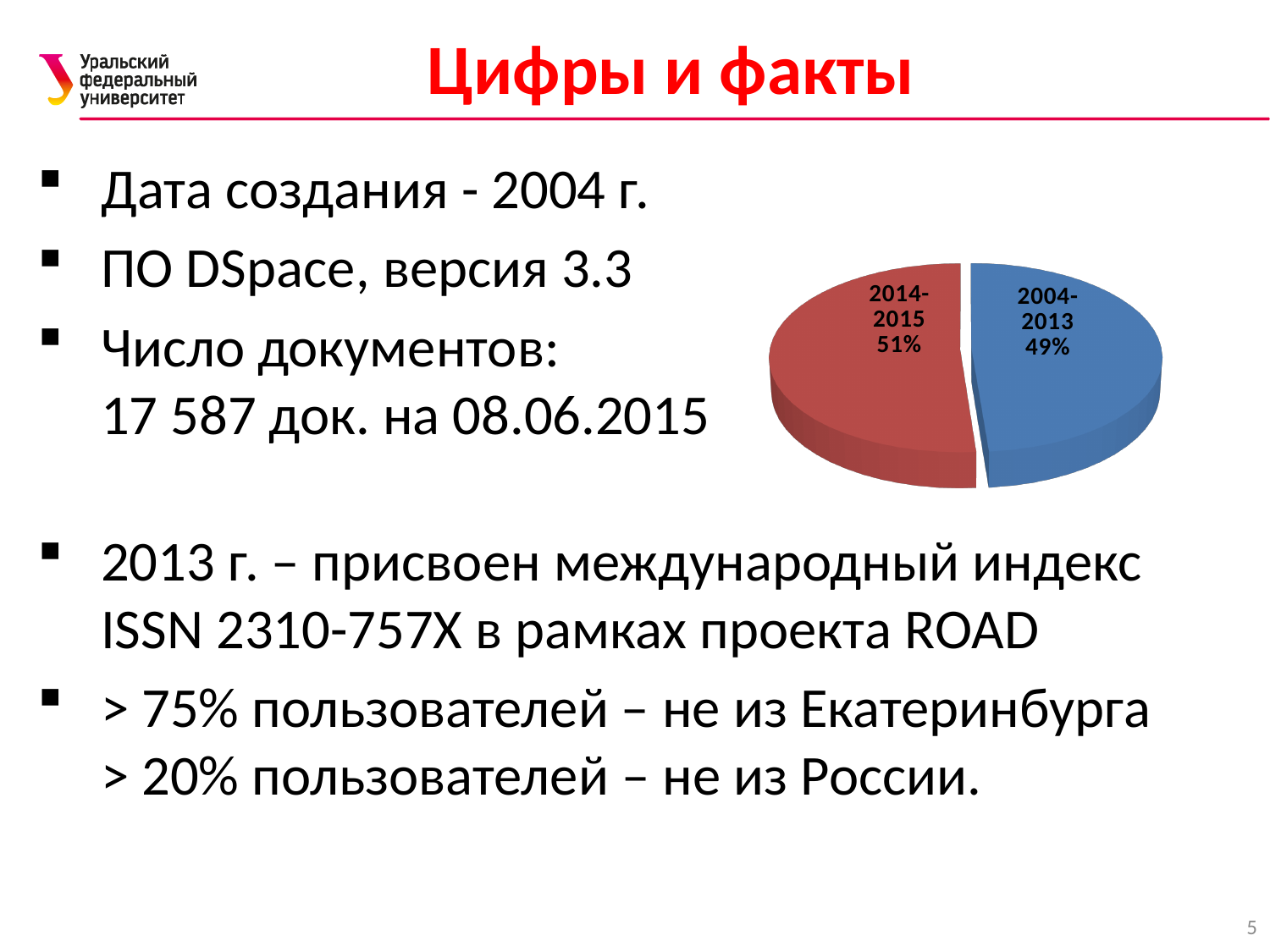
Which slice of the pie chart is the smallest? 2004-2013 Is the share of the 2014-2015 slice greater or less than 50%? greater What share of the pie chart does the 2004-2013 slice represent? 49% What share of the pie chart does the 2014-2015 slice represent? 51% Which slice of the pie chart is the largest? 2014-2015 How many slices does the pie chart have? 2 What colour is the 2014-2015 slice of the pie chart? Red What is the difference in percentage points between the 2014-2015 slice and the 2004-2013 slice? 2 Which is larger in the pie chart: the 2004-2013 slice or the 2014-2015 slice? 2014-2015 Is the share of the 2004-2013 slice greater or less than 50%? less What colour is the 2004-2013 slice of the pie chart? Blue What kind of chart is shown on the slide? Pie chart